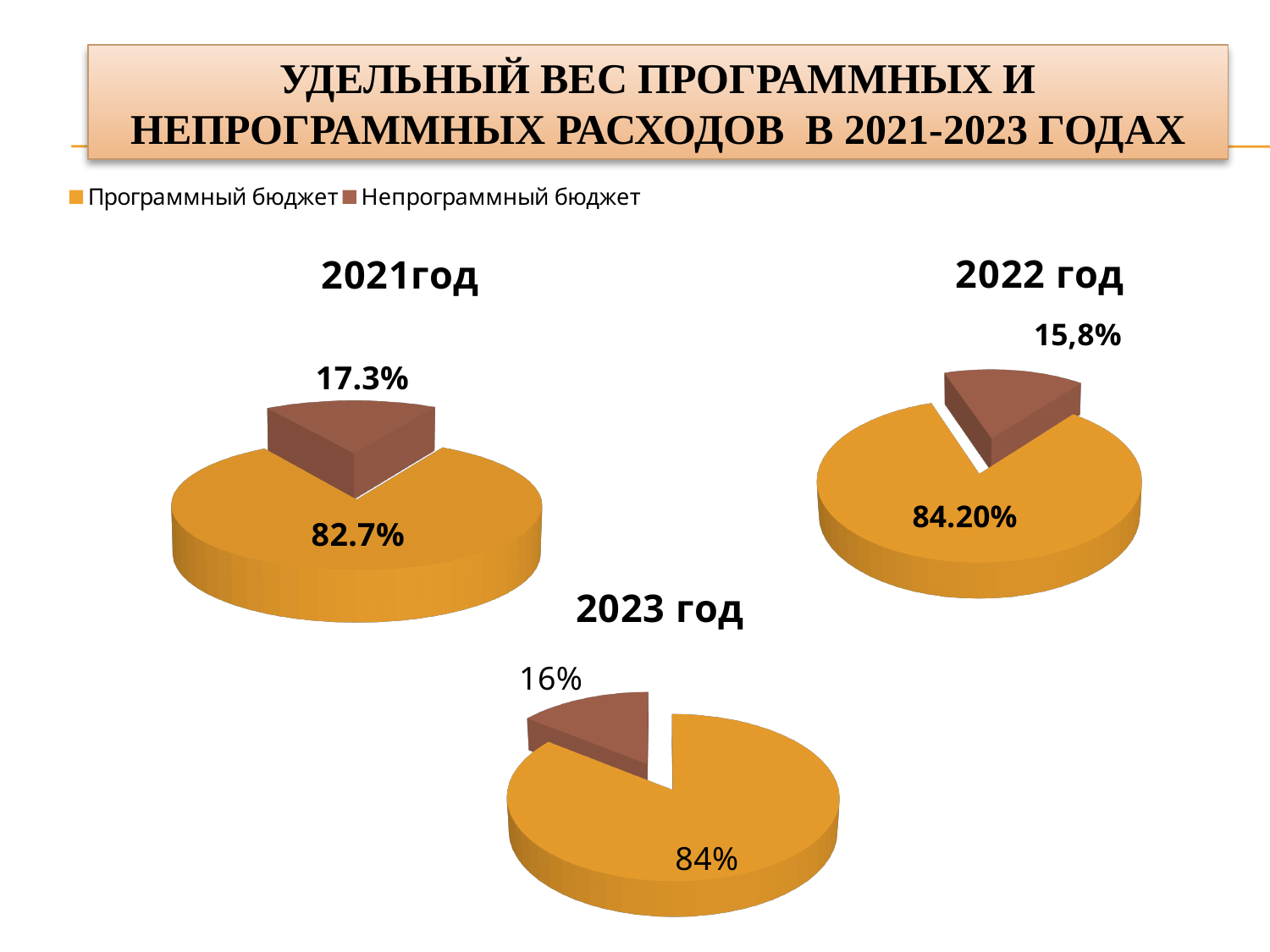
What kind of chart is used for 2022 год? Pie chart On the 2021год chart, which slice is the largest? Программный бюджет On the 2022 год chart, what is the share of Непрограммный бюджет? 15,8% How many pie charts are shown on the slide? 3 On the 2022 год chart, what is the share of Программный бюджет? 84.20% On the 2023 год chart, what is the share of Программный бюджет? 84% On the 2023 год chart, what is the share of Непрограммный бюджет? 16% On the 2021год chart, what is the share of Программный бюджет? 82.7% On the 2023 год chart, which slice is the smallest? Непрограммный бюджет How many series does the legend list? 2 On the 2021год chart, what is the difference between the Программный бюджет and Непрограммный бюджет shares? 65.4% On the 2021год chart, what is the share of Непрограммный бюджет? 17.3%